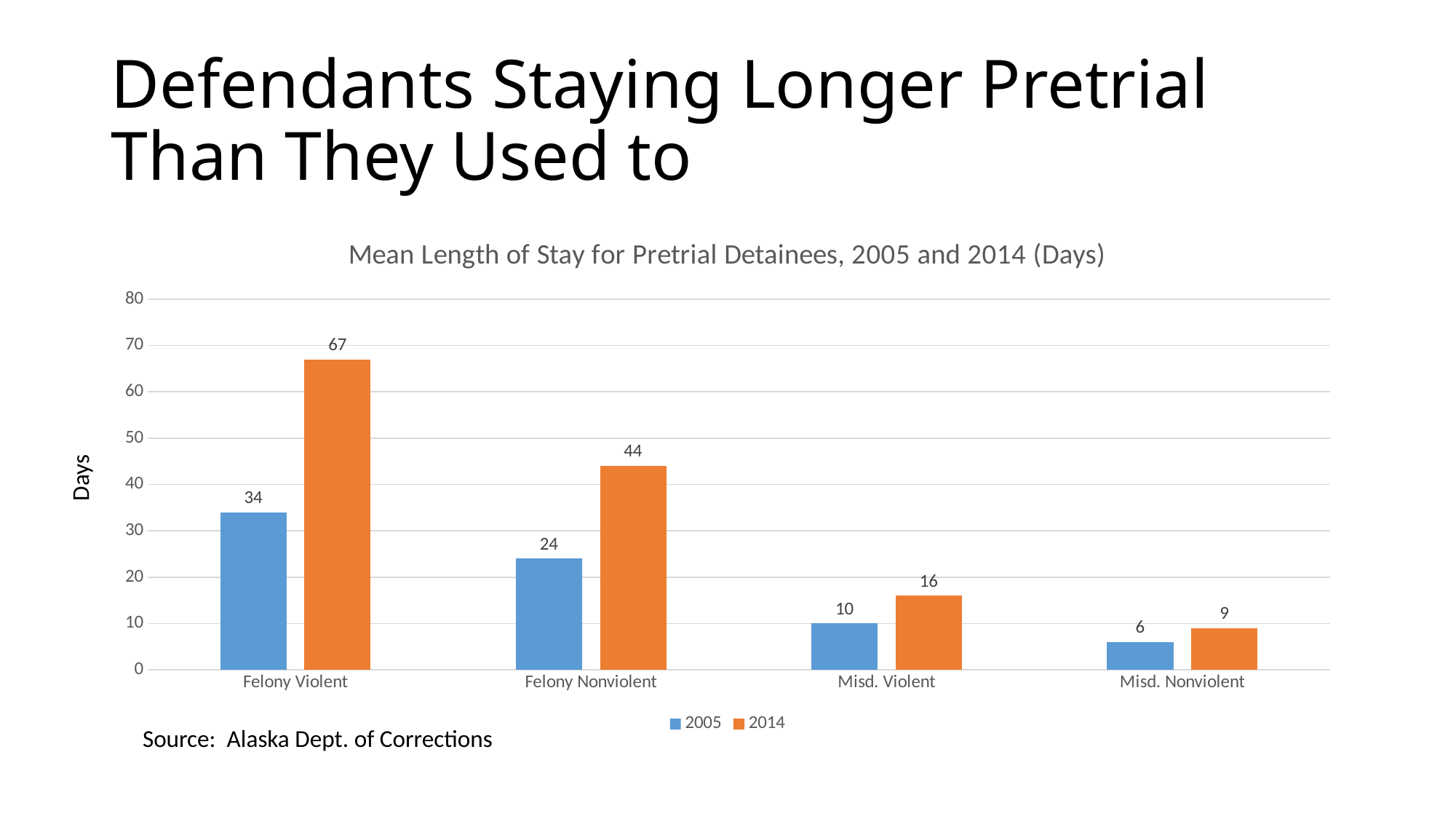
What was the mean length of stay for Felony Nonviolent pretrial detainees in 2005? 24 What was the mean length of stay for Misd. Nonviolent pretrial detainees in 2005? 6 How many series does the legend list? 2 What is the difference between the 2014 values for Felony Nonviolent and Misd. Violent? 28 What kind of chart is shown on the slide? Bar chart Which is larger: the 2005 value for Felony Violent or the 2014 value for Felony Nonviolent? 2014 value for Felony Nonviolent Which category had the lowest mean length of stay in 2005? Misd. Nonviolent How many offense categories are shown on the x axis? 4 By how many days did the mean length of stay for Felony Violent detainees increase from 2005 to 2014? 33 Which category had the highest mean length of stay in 2014? Felony Violent What is the title of the chart? Mean Length of Stay for Pretrial Detainees, 2005 and 2014 (Days) What was the mean length of stay for Felony Violent pretrial detainees in 2014? 67